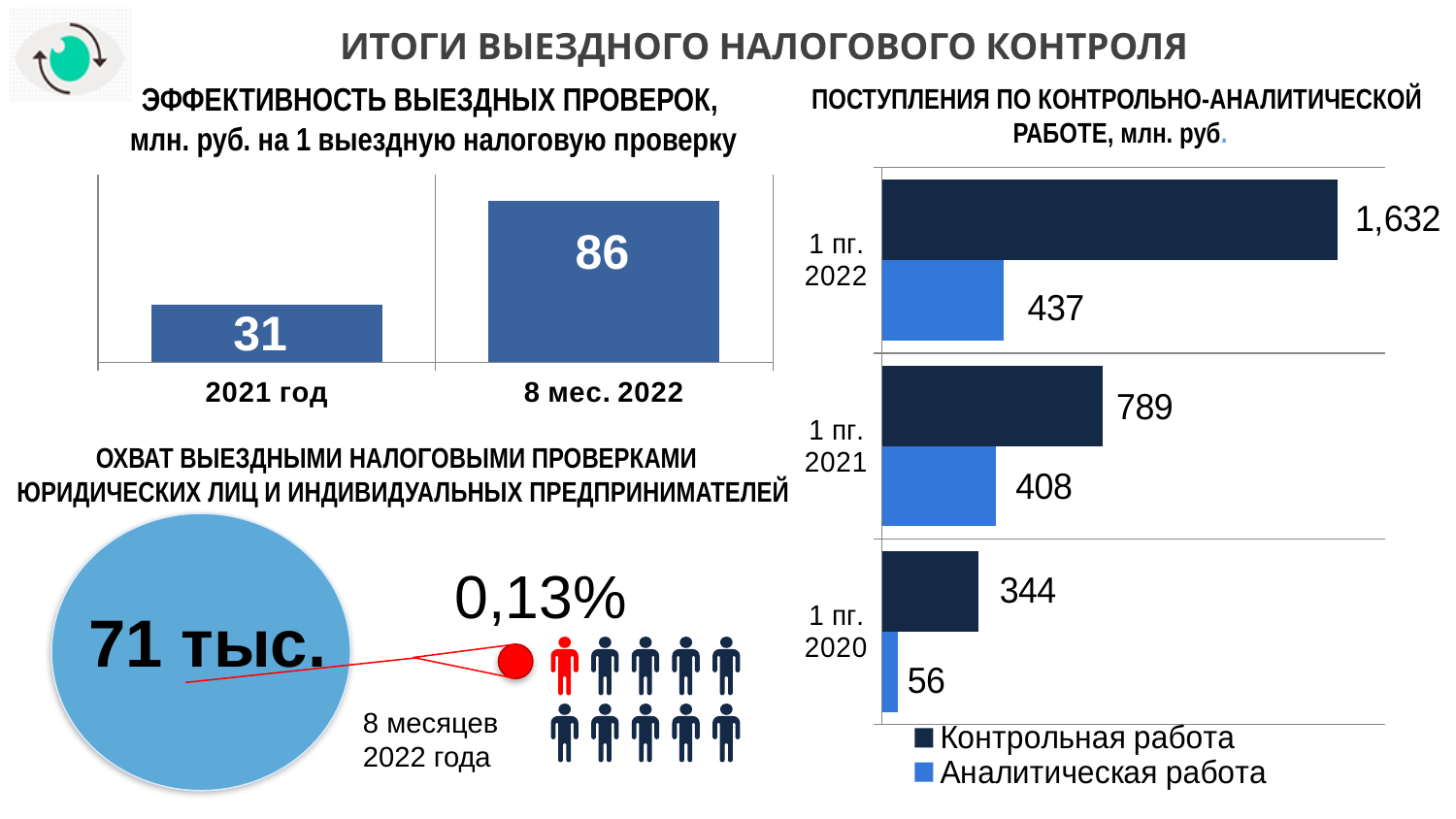
In the chart 'ПОСТУПЛЕНИЯ ПО КОНТРОЛЬНО-АНАЛИТИЧЕСКОЙ РАБОТЕ', what is the difference between 'Контрольная работа' and 'Аналитическая работа' for '1 пг. 2021'? 381 In the chart 'ПОСТУПЛЕНИЯ ПО КОНТРОЛЬНО-АНАЛИТИЧЕСКОЙ РАБОТЕ', what is the value of 'Аналитическая работа' for '1 пг. 2020'? 56 In the chart 'ЭФФЕКТИВНОСТЬ ВЫЕЗДНЫХ ПРОВЕРОК', what is the difference between the values for '8 мес. 2022' and '2021 год'? 55 In the chart 'ЭФФЕКТИВНОСТЬ ВЫЕЗДНЫХ ПРОВЕРОК', how many categories are shown? 2 In the chart 'ПОСТУПЛЕНИЯ ПО КОНТРОЛЬНО-АНАЛИТИЧЕСКОЙ РАБОТЕ', does the value of 'Контрольная работа' rise or fall from '1 пг. 2020' to '1 пг. 2022'? Rise In the chart 'ПОСТУПЛЕНИЯ ПО КОНТРОЛЬНО-АНАЛИТИЧЕСКОЙ РАБОТЕ', what is the value of 'Контрольная работа' for '1 пг. 2022'? 1,632 In the chart 'ПОСТУПЛЕНИЯ ПО КОНТРОЛЬНО-АНАЛИТИЧЕСКОЙ РАБОТЕ', which period has the lowest value for 'Аналитическая работа'? 1 пг. 2020 In the chart 'ПОСТУПЛЕНИЯ ПО КОНТРОЛЬНО-АНАЛИТИЧЕСКОЙ РАБОТЕ', how many series does the legend list? 2 In the chart 'ЭФФЕКТИВНОСТЬ ВЫЕЗДНЫХ ПРОВЕРОК', what is the value for '2021 год'? 31 In the chart 'ПОСТУПЛЕНИЯ ПО КОНТРОЛЬНО-АНАЛИТИЧЕСКОЙ РАБОТЕ', which period has the highest value for 'Контрольная работа'? 1 пг. 2022 What kind of chart is 'ЭФФЕКТИВНОСТЬ ВЫЕЗДНЫХ ПРОВЕРОК'? Bar chart In the chart 'ЭФФЕКТИВНОСТЬ ВЫЕЗДНЫХ ПРОВЕРОК', what is the value for '8 мес. 2022'? 86